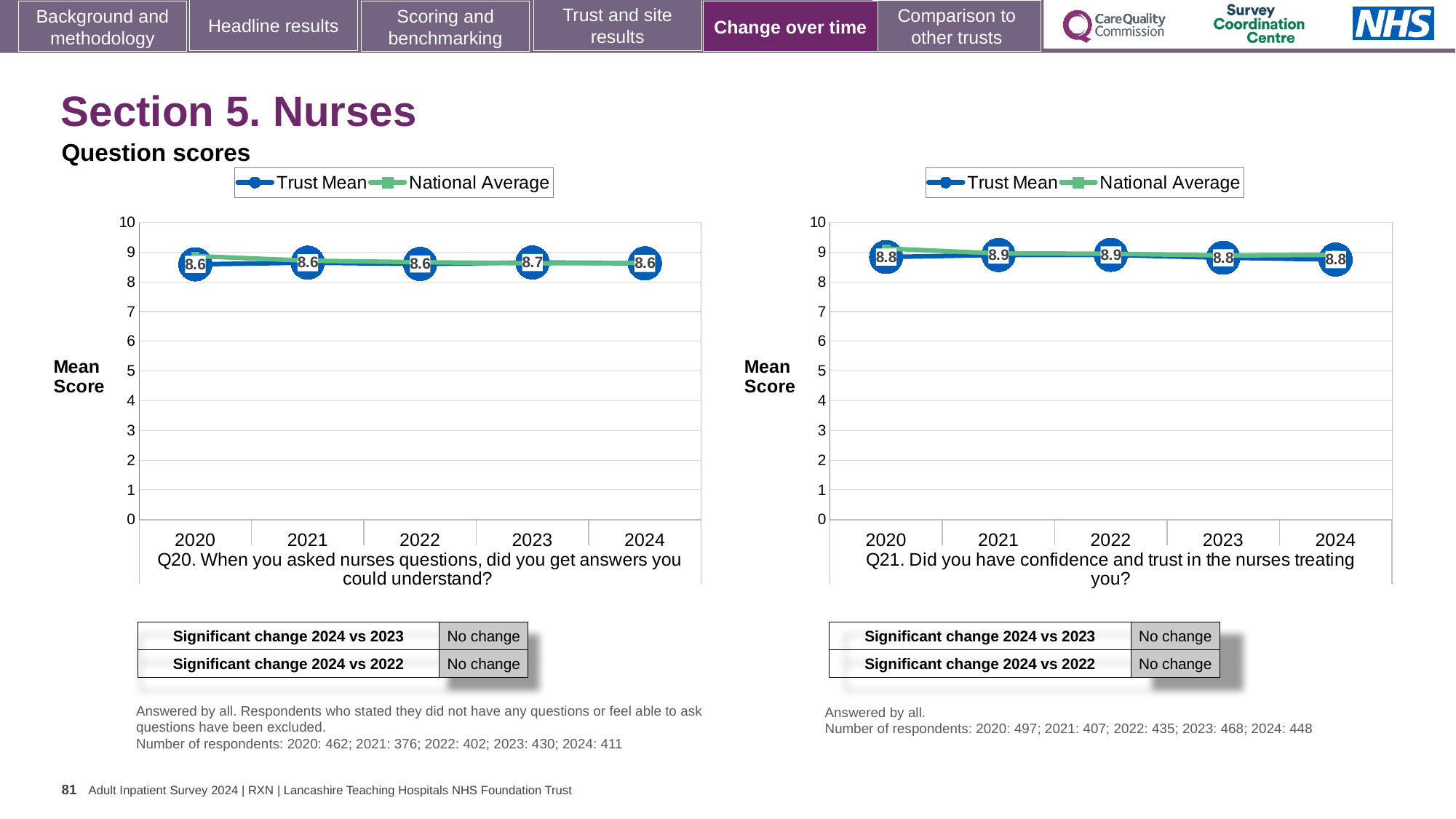
On the Q20 chart, what is the difference between the Trust Mean scores for 2023 and 2024? 0.1 On the Q20 chart, what is the Trust Mean score for 2023? 8.7 On the Q20 chart, what is the Trust Mean score for 2020? 8.6 On the Q20 chart, which year has the highest Trust Mean score? 2023 How many years are plotted on the Q20 chart? 5 On the Q21 chart, what is the Trust Mean score for 2021? 8.9 On the Q21 chart, which is larger, the Trust Mean score for 2022 or for 2023? 2022 On the Q21 chart, what is the Trust Mean score for 2024? 8.8 What kind of chart is the Q20 chart? Line chart How many series does the legend of the Q21 chart list? 2 On the Q21 chart, is the National Average value for 2020 greater or less than 8? greater What is the label of the y axis on the Q21 chart? Mean Score